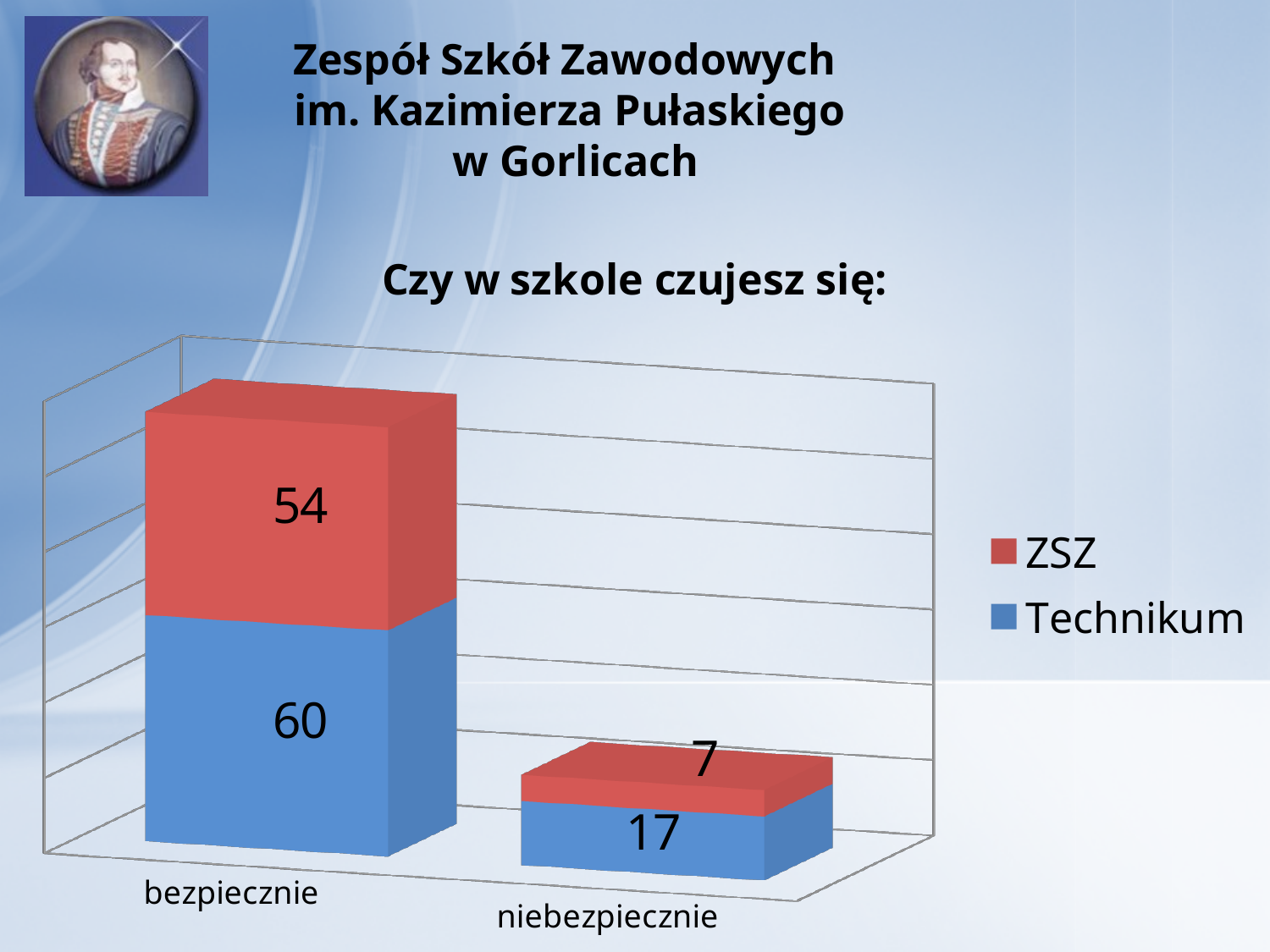
Which category has the lowest ZSZ value? niebezpiecznie How many categories are shown on the x axis? 2 Which category has the highest total stacked value? bezpiecznie What is the ZSZ value for "niebezpiecznie"? 7 What is the Technikum value for "bezpiecznie"? 60 How many series does the legend list? 2 Which is larger for "bezpiecznie": the ZSZ value or the Technikum value? Technikum What is the total of the stacked bar for "niebezpiecznie"? 24 What is the Technikum value for "niebezpiecznie"? 17 What is the difference between the Technikum values for "bezpiecznie" and "niebezpiecznie"? 43 What kind of chart is shown? stacked bar chart What is the ZSZ value for "bezpiecznie"? 54